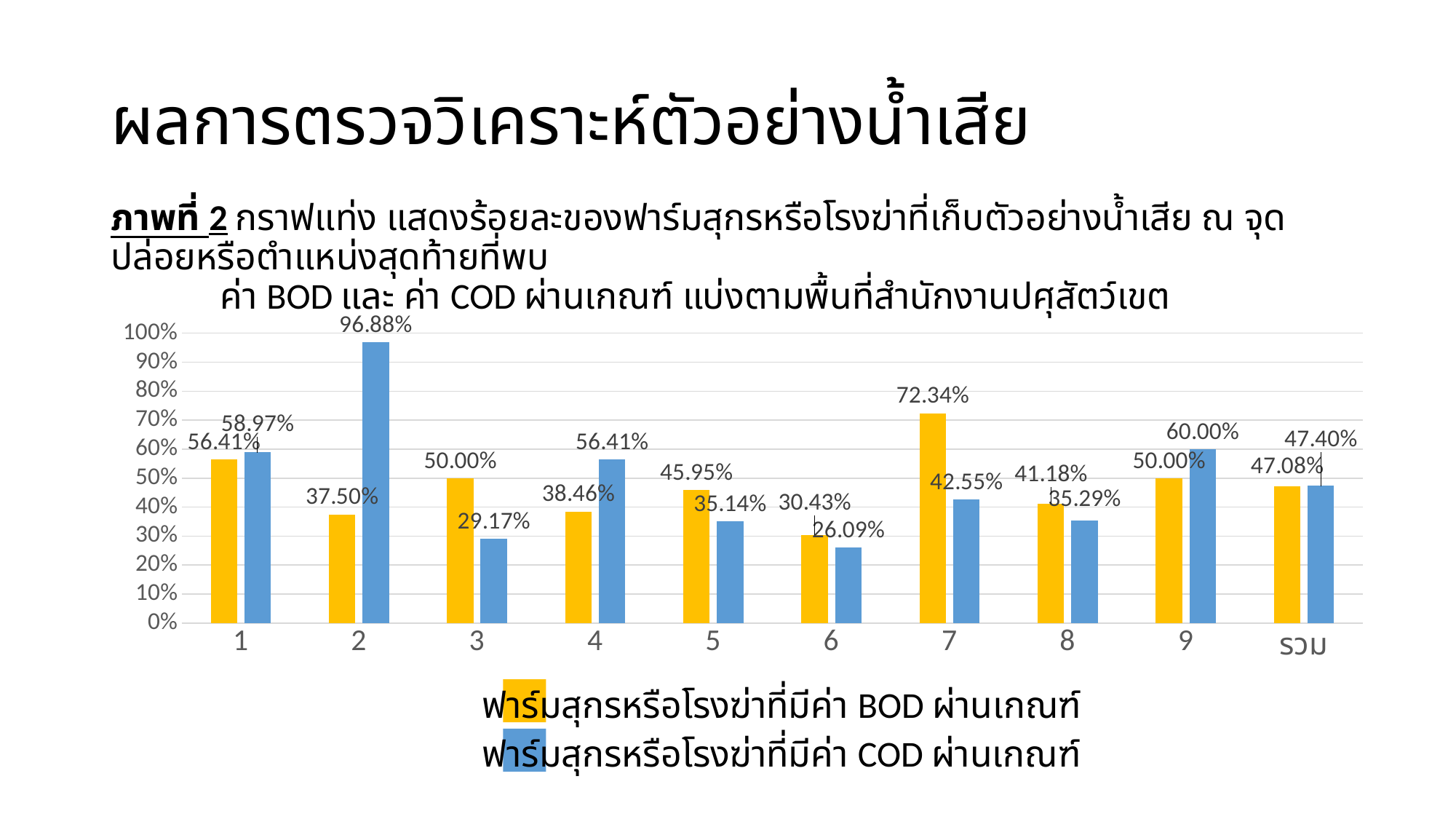
How many categories are shown on the x axis? 10 What is the BOD pass percentage for the รวม (total) category? 47.08% How many series does the legend list? 2 What type of chart is shown on the slide? bar chart What is the difference between the BOD and COD pass percentages in area 7? 29.79% What is the percentage of farms or slaughterhouses passing the COD criterion in area 2? 96.88% What is the percentage of farms or slaughterhouses passing the BOD criterion in area 7? 72.34% Which area has the highest COD pass percentage? 2 Which colour represents farms or slaughterhouses passing the COD criterion? blue In area 3, which is larger: the BOD pass percentage or the COD pass percentage? BOD pass percentage Which area has the lowest BOD pass percentage? 6 What is the difference between the COD and BOD pass percentages in area 2? 59.38%